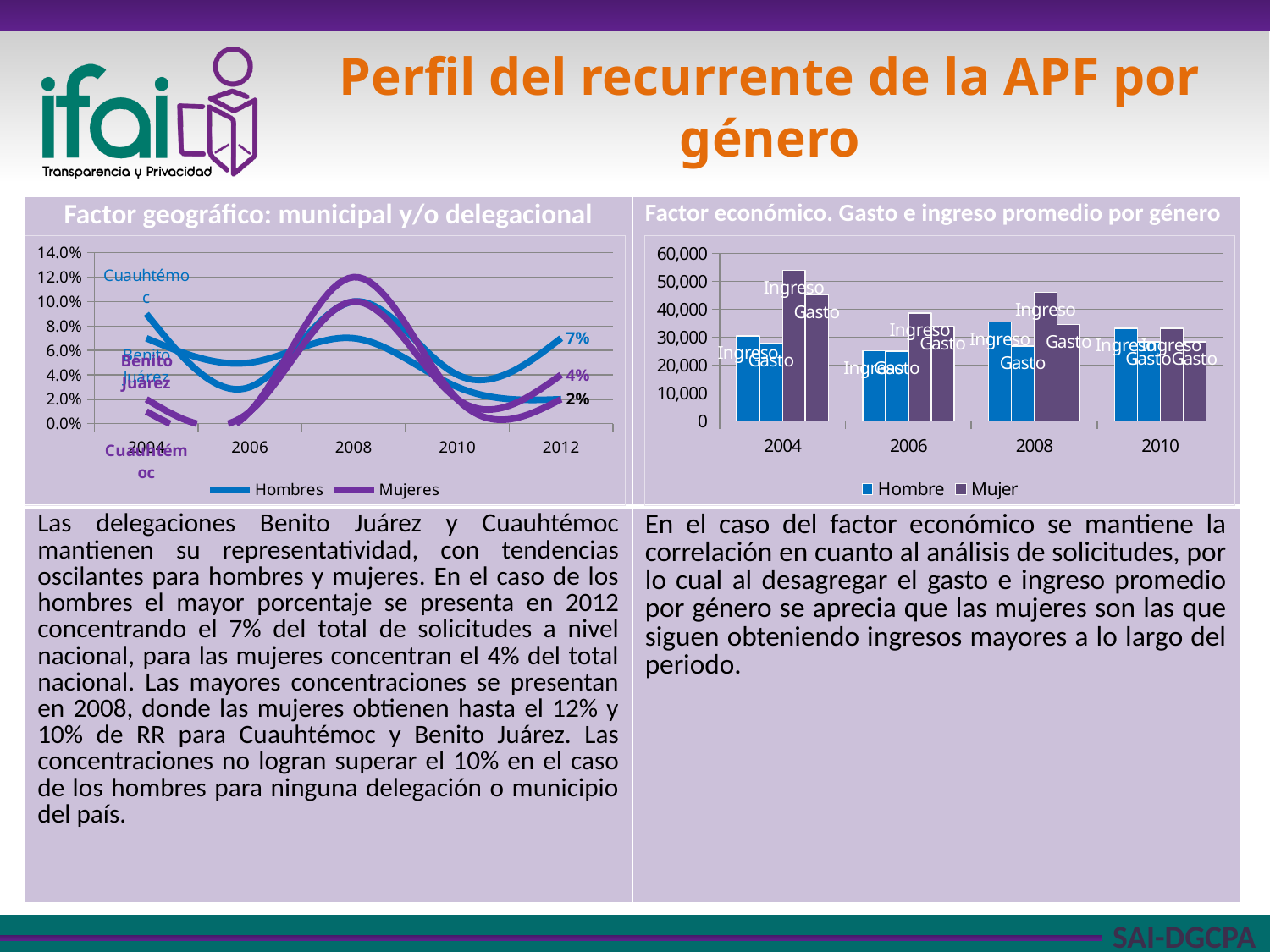
In the right chart, is the Hombre Ingreso bar for 2006 greater or less than 30,000? less How many series does the legend of the left chart list? 2 In the right chart, for 2008, which is larger: the Hombre Ingreso bar or the Mujer Ingreso bar? Mujer Ingreso How many years are shown on the x axis of the right chart? 4 In the right chart, is the Mujer Ingreso bar for 2004 greater or less than 50,000? greater What are the two legend entries of the right chart? Hombre and Mujer What kind of chart is the right chart titled 'Factor económico. Gasto e ingreso promedio por género'? bar chart In the right chart, is the Mujer Ingreso bar for 2008 greater or less than 40,000? greater How many series does the legend of the right chart list? 2 In the right chart, which year contains the tallest bar? 2004 What kind of chart is the left chart titled 'Factor geográfico: municipal y/o delegacional'? line chart In the left chart, what is the highest value labeled at 2012? 7%